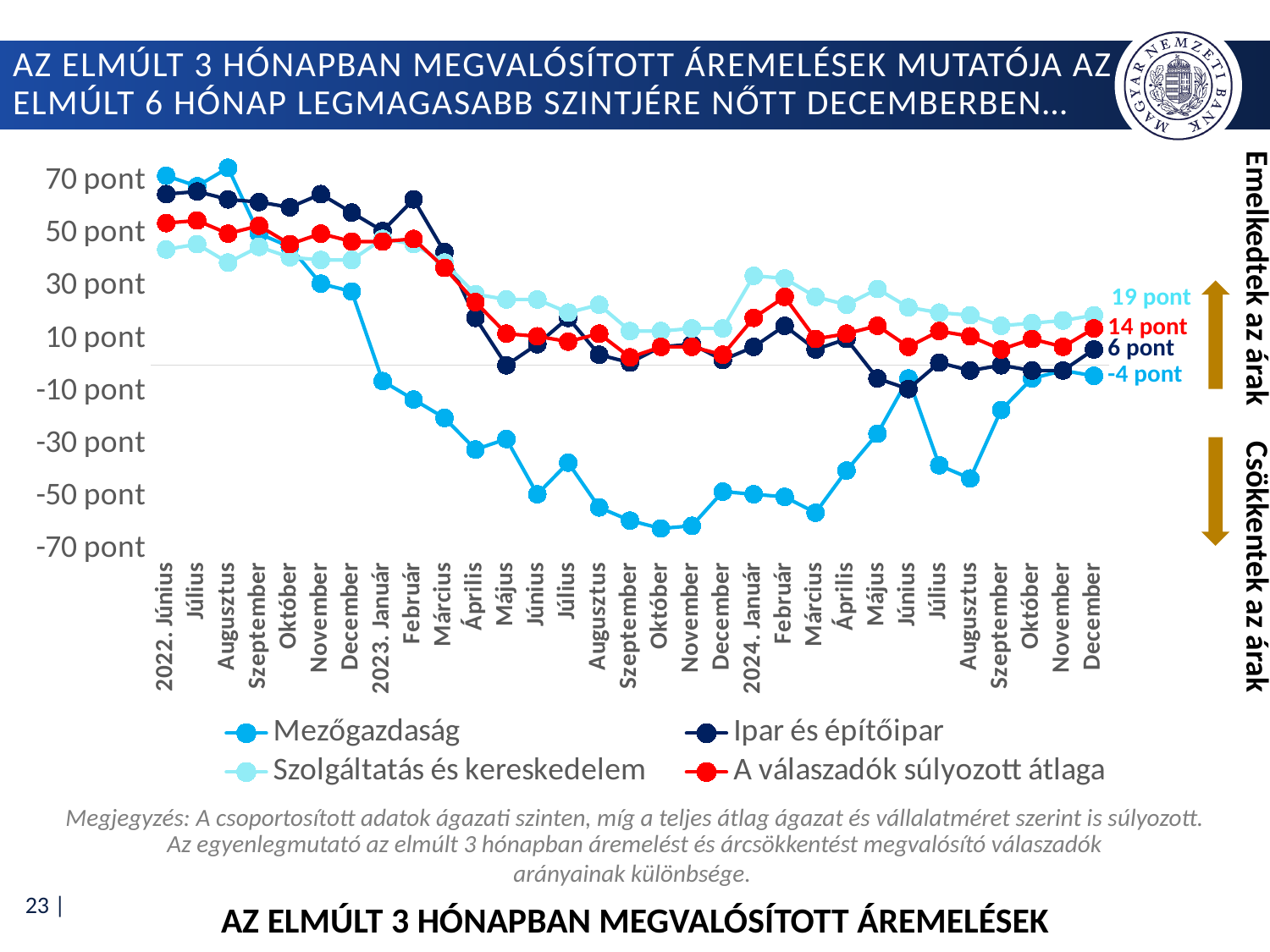
Which series has the highest value in December 2024? Szolgáltatás és kereskedelem What is the December 2024 value for Ipar és építőipar? 6 pont What is the December 2024 value for A válaszadók súlyozott átlaga? 14 pont Which series has the lowest value in December 2024? Mezőgazdaság How many series does the legend list? 4 What is the December 2024 value for Szolgáltatás és kereskedelem? 19 pont What is the December 2024 value for Mezőgazdaság? -4 pont What kind of chart is shown on the slide? Line chart Is the value for Ipar és építőipar in 2022 Június greater or less than 50 pont? greater In December 2024, which is larger: the value for Ipar és építőipar or the value for Mezőgazdaság? Ipar és építőipar What is the difference between the December 2024 values of Szolgáltatás és kereskedelem and A válaszadók súlyozott átlaga? 5 pont Is the value for Mezőgazdaság in 2023 Október greater or less than -50 pont? less